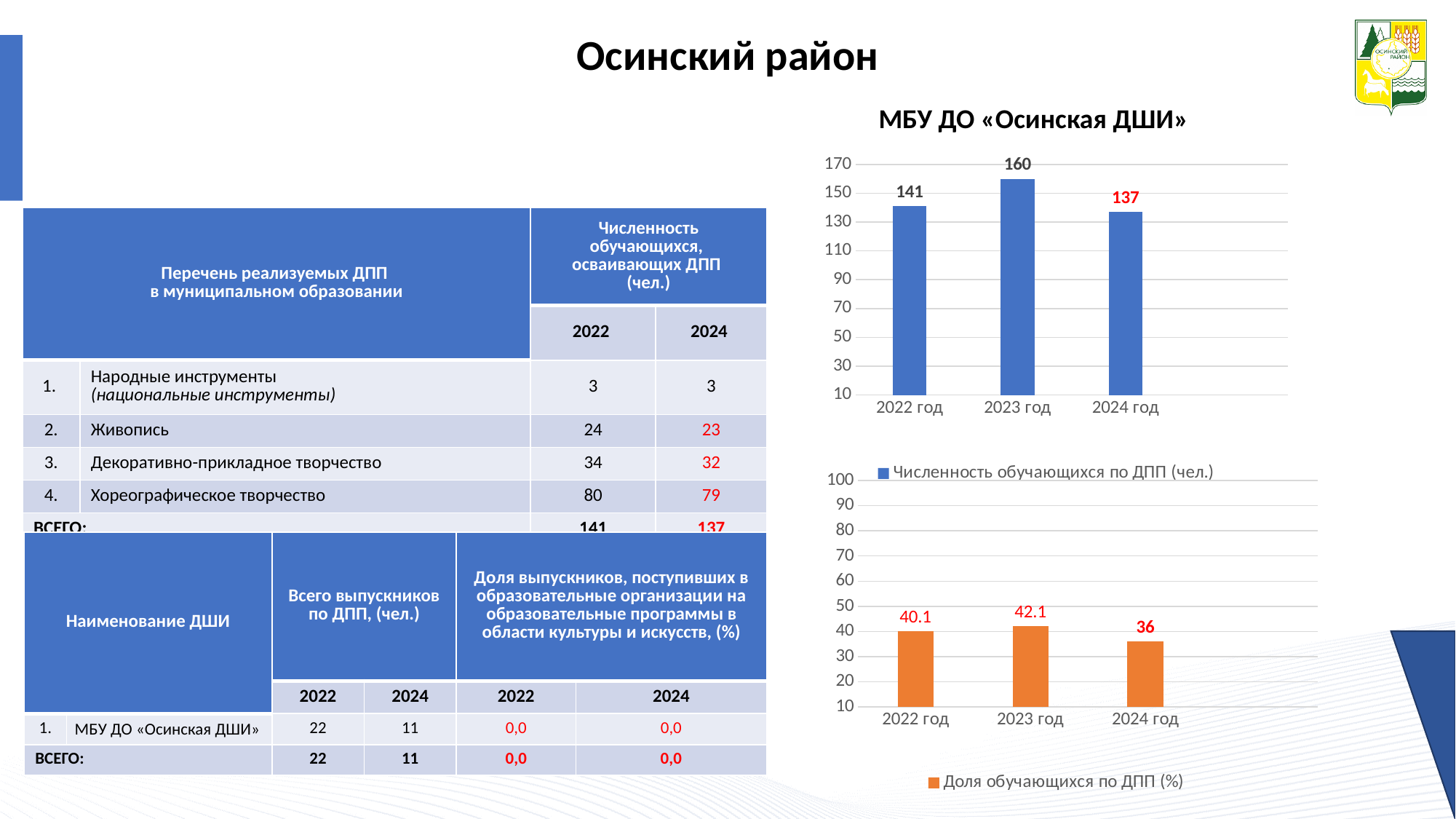
In the top chart titled «МБУ ДО «Осинская ДШИ»», what is the value for 2024 год? 137 What is the legend entry of the bottom chart on the right (orange bars)? Доля обучающихся по ДПП (%) In the top chart titled «МБУ ДО «Осинская ДШИ»», which year has the highest value? 2023 год In the bottom chart on the right (orange bars), is the value for 2023 год larger or smaller than the value for 2024 год? Larger In the bottom chart on the right (orange bars), what is the value for 2024 год? 36 In the top chart titled «МБУ ДО «Осинская ДШИ»», what is the difference between the values for 2023 год and 2022 год? 19 In the bottom chart on the right (orange bars), what is the value for 2022 год? 40.1 What type of chart is the top chart titled «МБУ ДО «Осинская ДШИ»»? Bar chart In the top chart titled «МБУ ДО «Осинская ДШИ»», how many bars are plotted? 3 In the bottom chart on the right (orange bars), which year has the highest value? 2023 год In the top chart titled «МБУ ДО «Осинская ДШИ»», which year has the lowest value? 2024 год In the top chart titled «МБУ ДО «Осинская ДШИ»», what is the value for 2023 год? 160